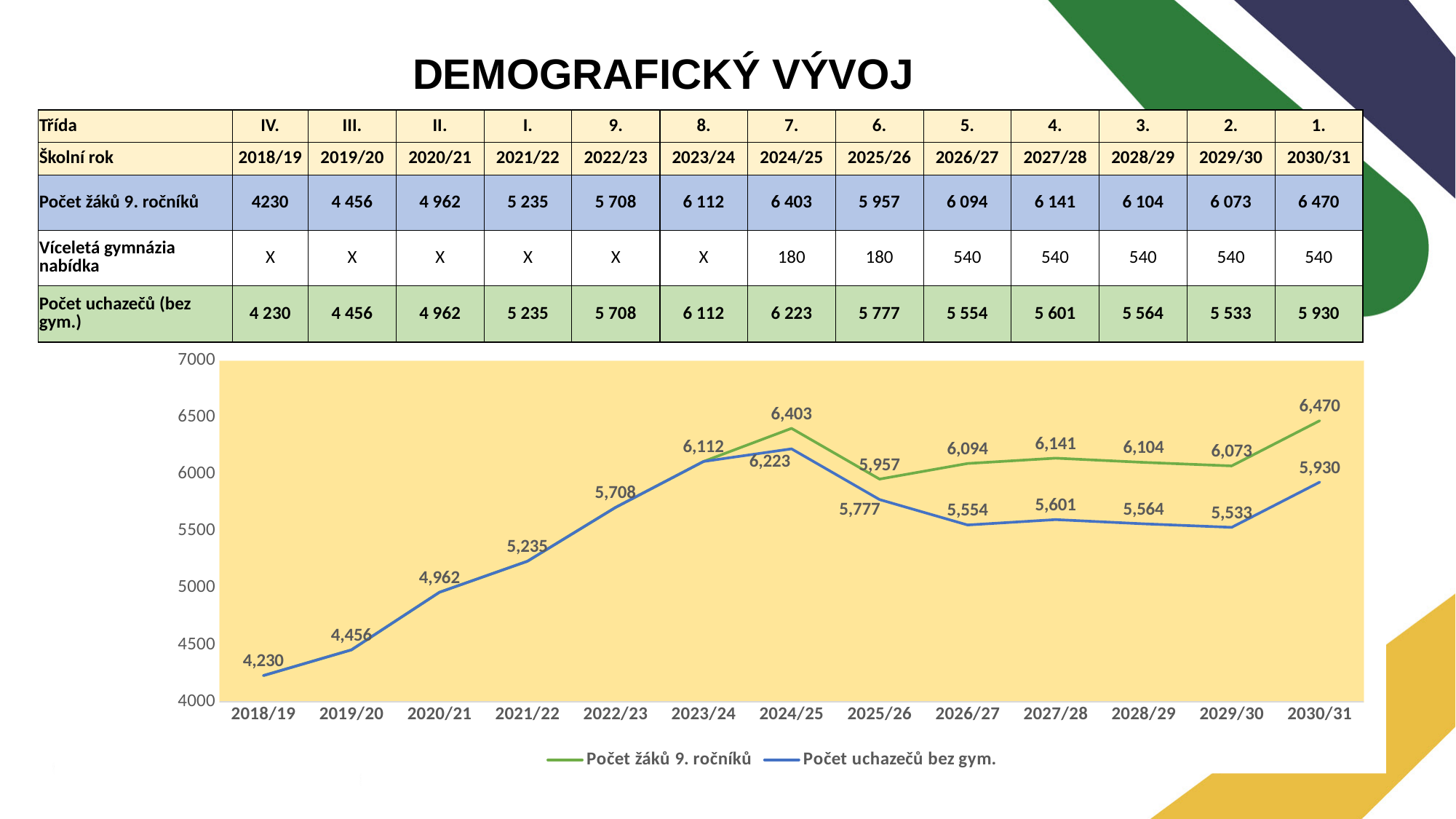
What is the value of Počet uchazečů bez gym. for 2030/31 in the chart? 5,930 Is the value of Počet uchazečů bez gym. for 2029/30 greater or less than 6000? less What is the value of Počet žáků 9. ročníků for 2024/25 in the chart? 6,403 Does Počet uchazečů bez gym. rise or fall from 2018/19 to 2023/24? rise What type of chart is shown on the slide? line chart How many school years are plotted along the x axis of the chart? 13 What is the difference between Počet žáků 9. ročníků and Počet uchazečů bez gym. in 2026/27? 540 How many series does the chart legend list? 2 In which school year does Počet žáků 9. ročníků reach its highest value? 2030/31 What colour is the line for Počet uchazečů bez gym. in the chart? blue Which series has the larger value in 2027/28, Počet žáků 9. ročníků or Počet uchazečů bez gym.? Počet žáků 9. ročníků In which school year is Počet uchazečů bez gym. at its lowest value? 2018/19